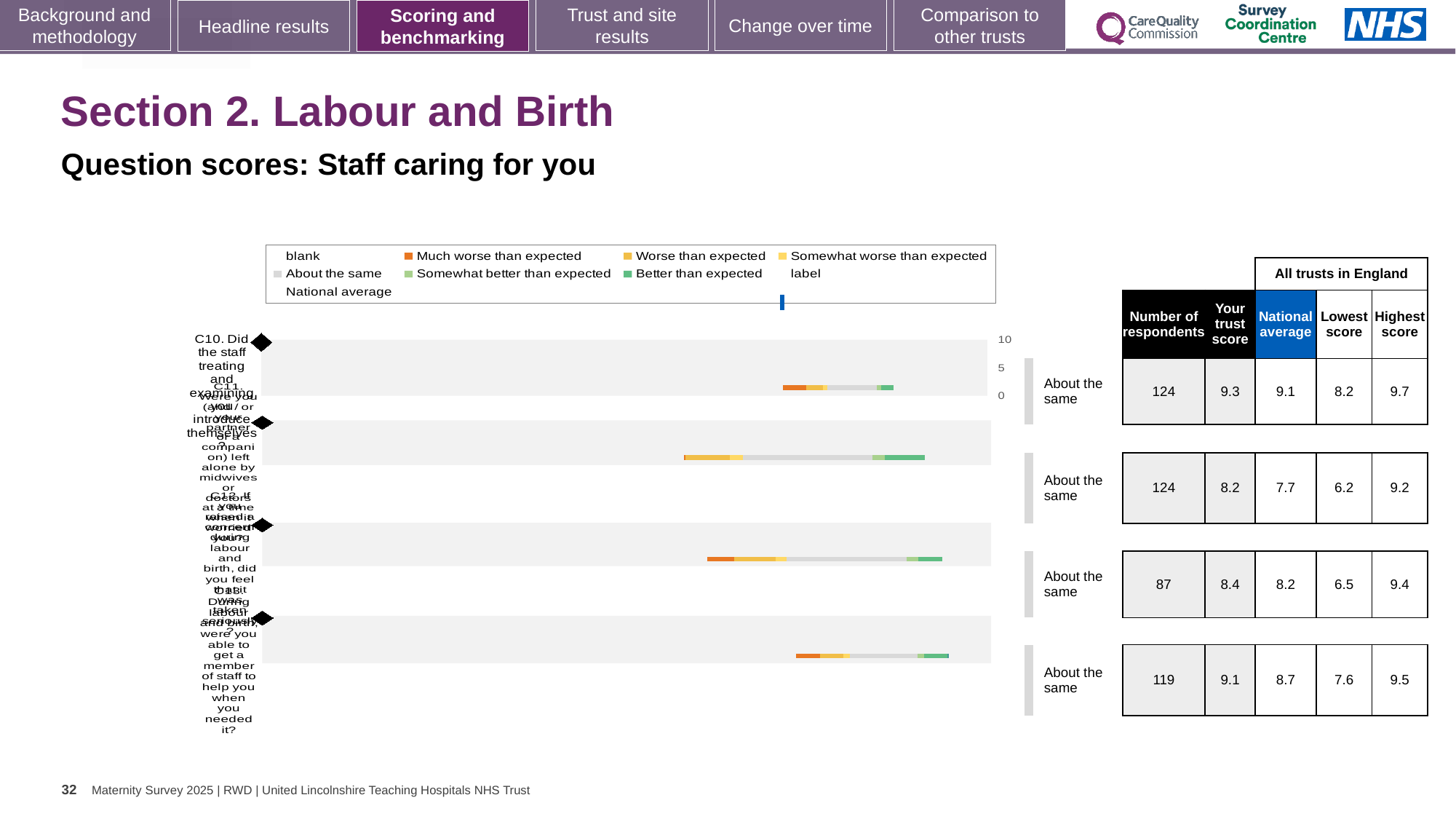
Which question has the highest 'Your trust score' in the table? C10 For question C11, what is the difference between the trust score and the national average? 0.5 What kind of chart is shown on the slide? bar chart What is the 'Your trust score' for question C10 (the first row of the table)? 9.3 What is the highest score across all trusts in England for question C12 (the third row of the table)? 9.4 How many respondents are listed for question C12 (the third row of the table)? 87 How many questions (rows) are shown in the chart and table? 4 What benchmark category is shown next to each question's bar? About the same What is the lowest score across all trusts in England for question C11 (the second row of the table)? 6.2 What is the national average for question C13 (the fourth row of the table)? 8.7 For question C13, is the trust score higher or lower than the national average? higher Which question has the lowest number of respondents in the table? C12